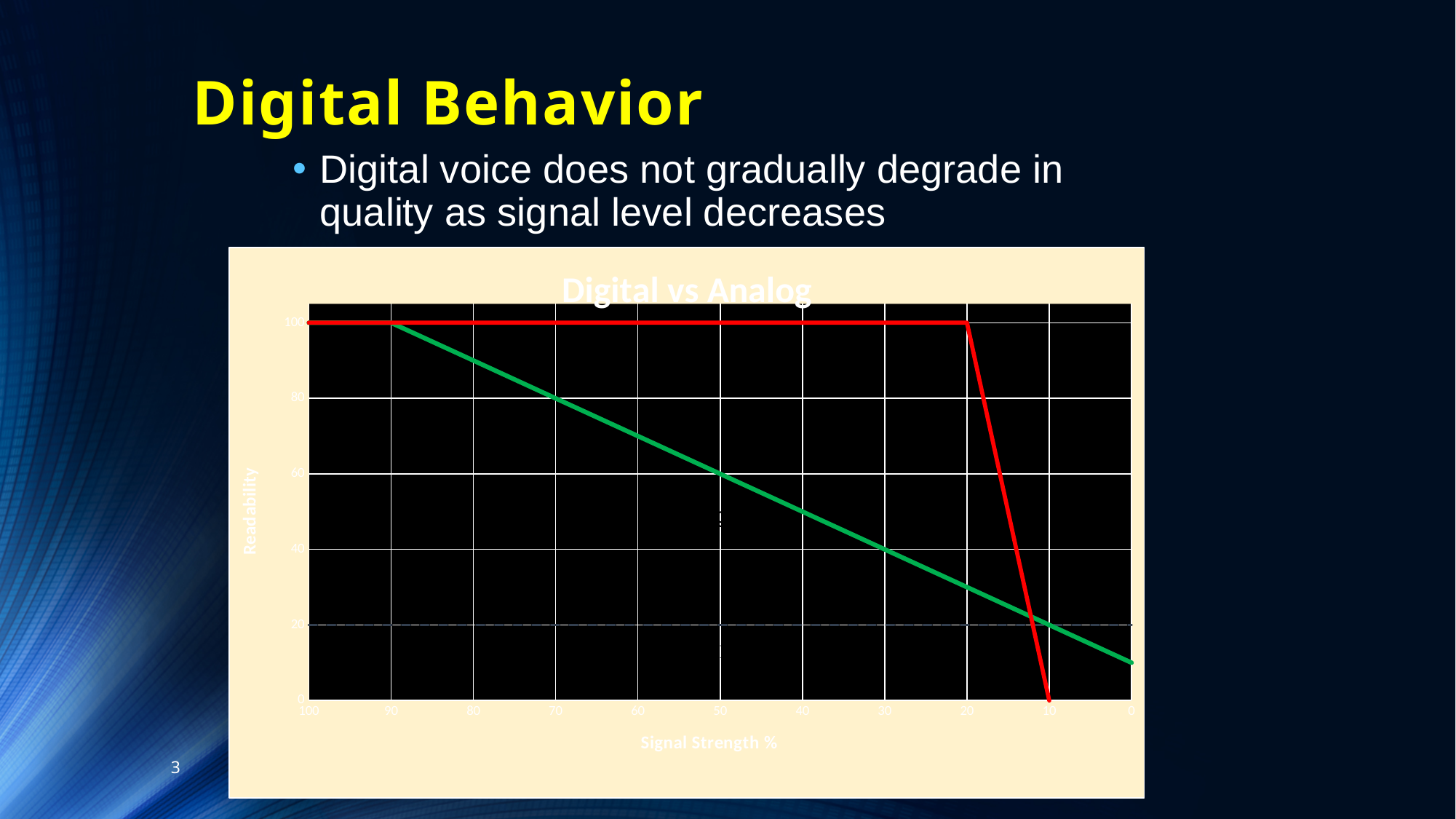
Is the readability of the green line at a signal strength of 60 greater or less than 60? greater What is the title of the chart? Digital vs Analog What is the label of the x axis of the chart? Signal Strength % What is the readability value of the green line at a signal strength of 30? 40 How many lines are plotted on the chart? 3 Does the green line rise or fall as signal strength decreases from 90 to 0 along the x axis? fall What is the readability value of the green line at a signal strength of 70? 80 What is the readability value of the red line at a signal strength of 10? 0 What is the readability value of the red line at a signal strength of 50? 100 What type of chart is shown on the slide? line chart At a signal strength of 50, what is the difference in readability between the red line (100) and the green line (60)? 40 At a signal strength of 50, which line has the higher readability, the red line or the green line? red line